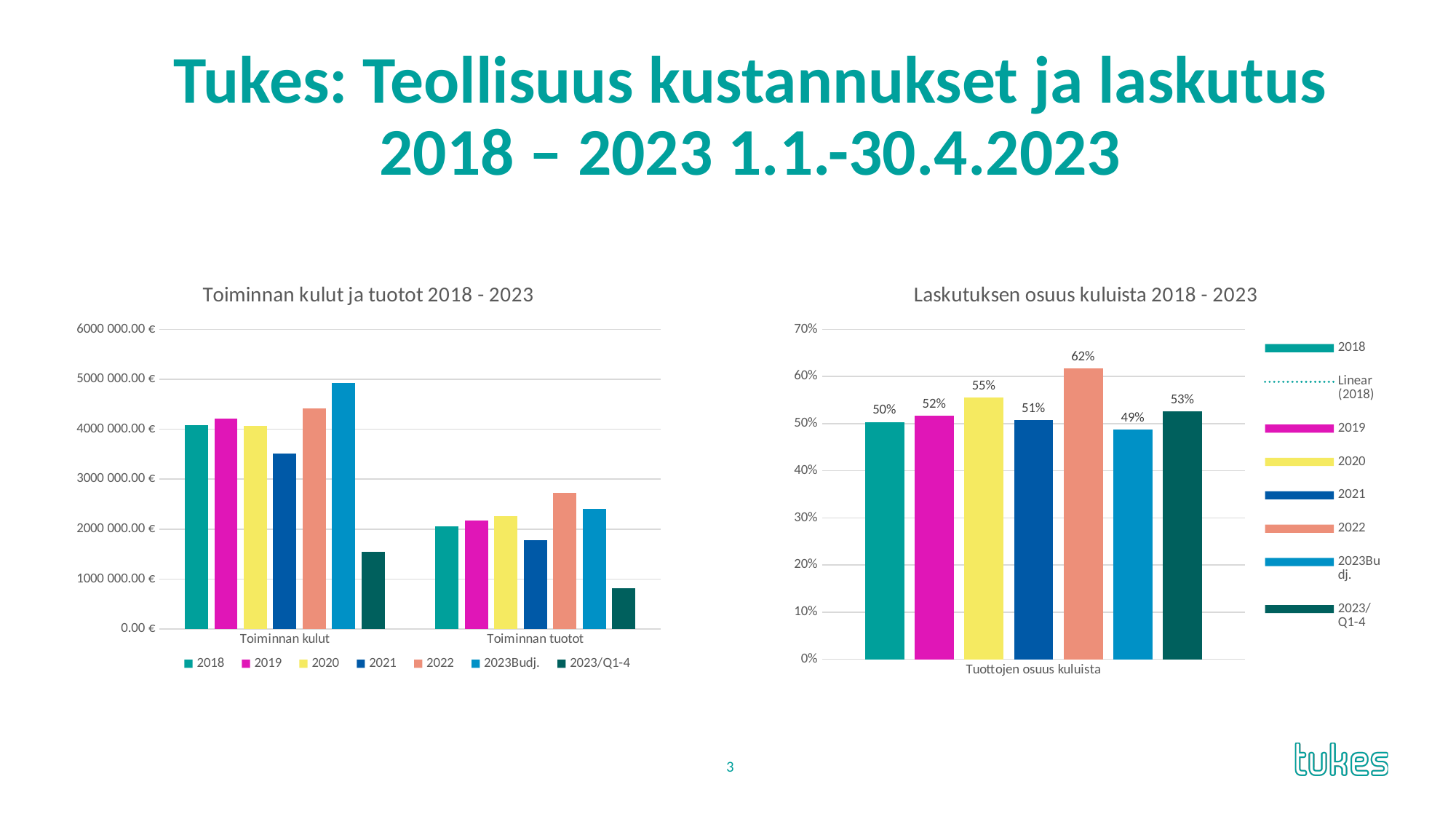
In the chart titled "Laskutuksen osuus kuluista 2018 - 2023", which is larger, the value for 2019 or the value for 2023/Q1-4? 2023/Q1-4 In the chart titled "Laskutuksen osuus kuluista 2018 - 2023", what is the value for 2023Budj.? 49% In the chart titled "Laskutuksen osuus kuluista 2018 - 2023", which series has the lowest value? 2023Budj. In the chart titled "Laskutuksen osuus kuluista 2018 - 2023", what is the difference between the 2022 value and the 2018 value? 12% In the chart titled "Laskutuksen osuus kuluista 2018 - 2023", which series has the highest value? 2022 What kind of chart is the chart titled "Toiminnan kulut ja tuotot 2018 - 2023"? Bar chart In the chart titled "Toiminnan kulut ja tuotot 2018 - 2023", is the 2023/Q1-4 value for Toiminnan tuotot greater or less than 1000 000.00 €? less In the chart titled "Toiminnan kulut ja tuotot 2018 - 2023", which series has the highest value for Toiminnan kulut? 2023Budj. How many series does the legend of the chart titled "Toiminnan kulut ja tuotot 2018 - 2023" list? 7 In the chart titled "Toiminnan kulut ja tuotot 2018 - 2023", is the 2023Budj. value for Toiminnan kulut greater or less than 4000 000.00 €? greater In the chart titled "Laskutuksen osuus kuluista 2018 - 2023", what is the value for 2020? 55% In the chart titled "Laskutuksen osuus kuluista 2018 - 2023", what is the value for 2022? 62%